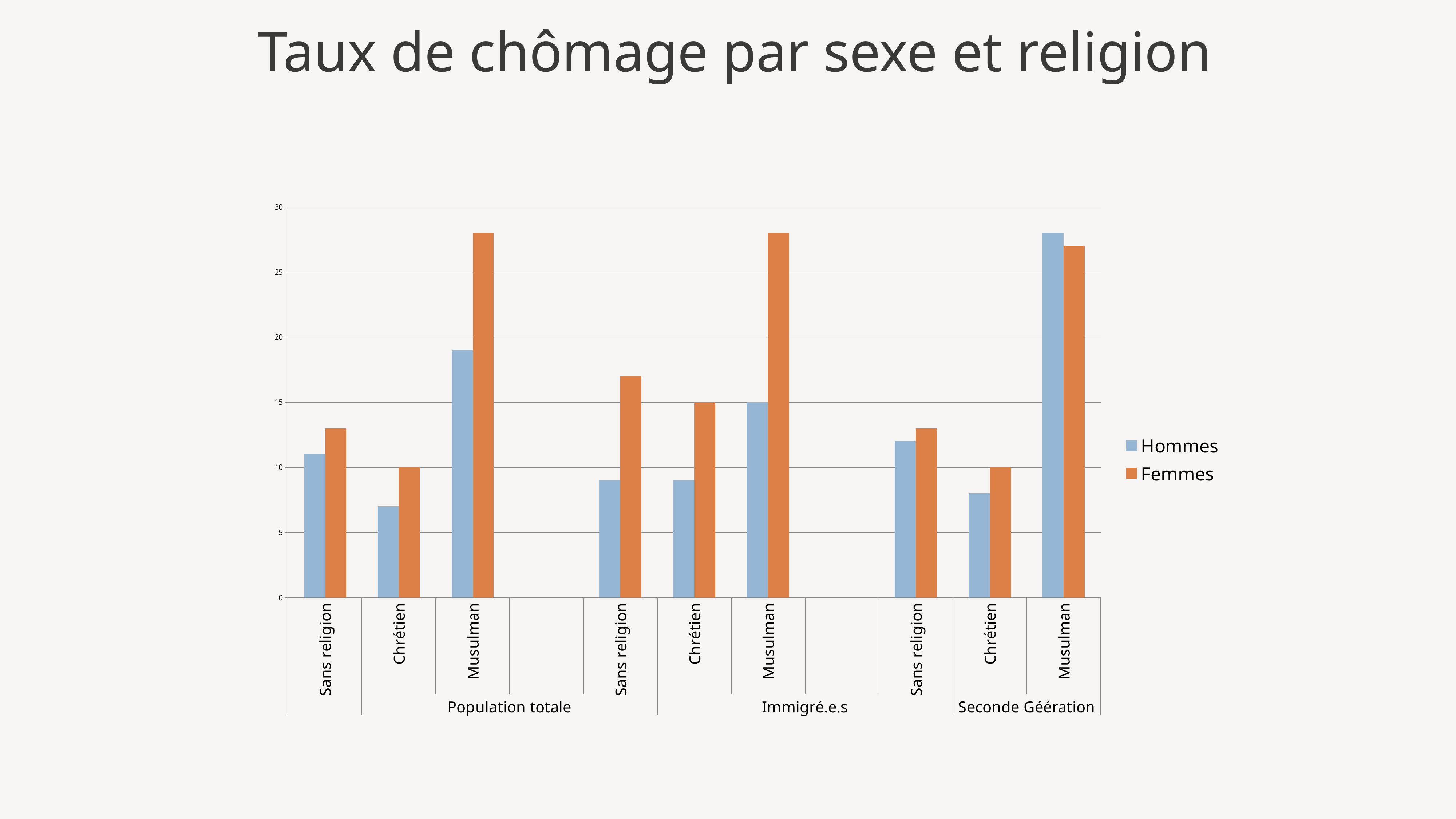
Is the Hommes value for Chrétien in the Population totale group greater or less than 10? less What kind of chart is shown on the slide? bar chart How many series does the legend list? 2 Is the Femmes value for Musulman in the Population totale group greater or less than 25? greater Is the Hommes value for Musulman in the Population totale group greater or less than 20? less In the Immigré.e.s group, which is larger for Sans religion: Hommes or Femmes? Femmes Which category has the highest Hommes value? Musulman (Seconde Géération) What are the two series named in the legend? Hommes, Femmes In the Population totale group, which is larger for Musulman: Hommes or Femmes? Femmes How many religion categories are plotted across all three groups? 9 What is the title of the chart? Taux de chômage par sexe et religion